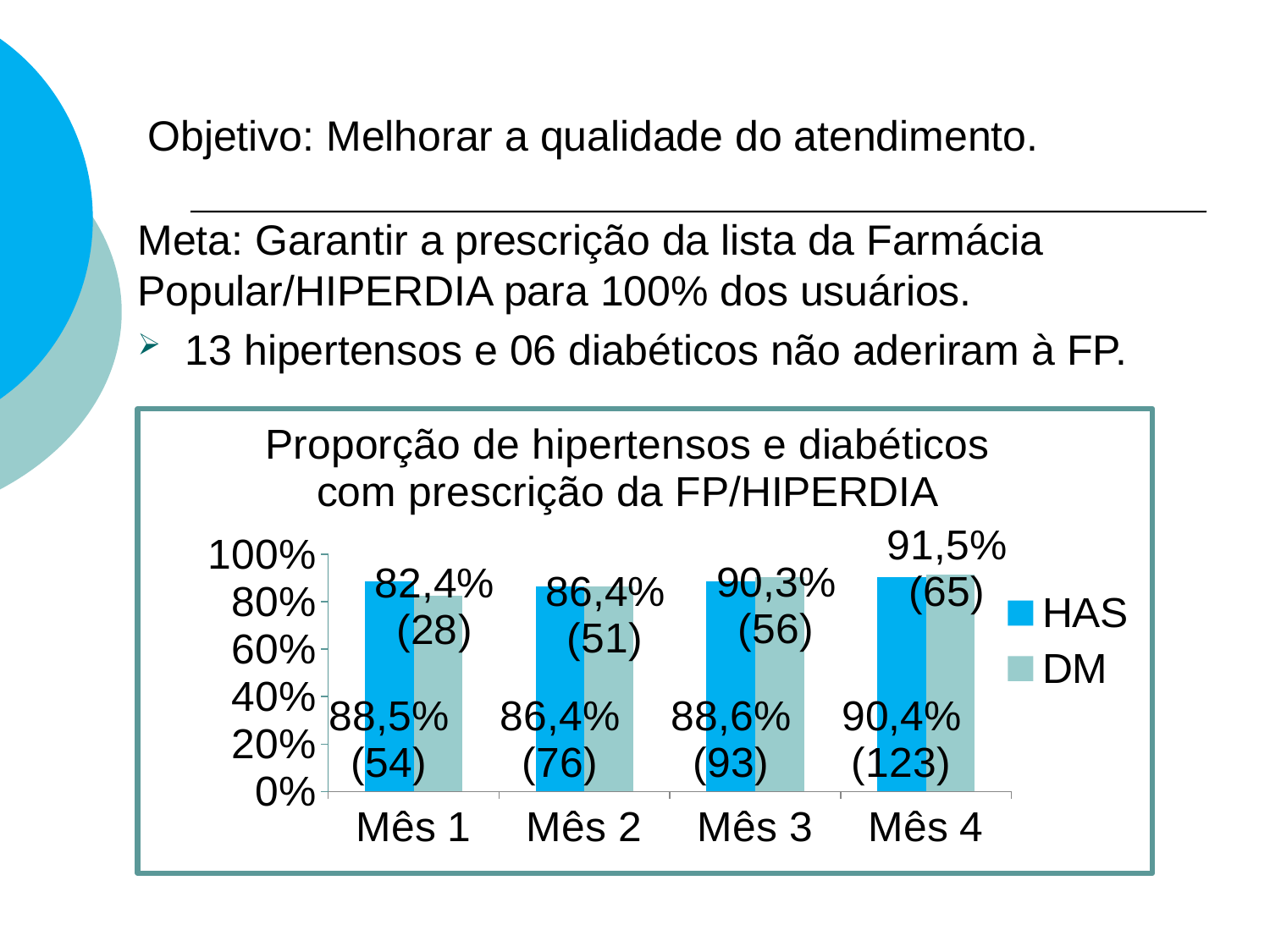
Which is larger in Mês 1, the HAS value or the DM value? HAS How many series does the legend list? 2 In which month is the DM value lowest? Mês 1 What is the HAS value for Mês 4? 90,4% What is the difference between the DM value in Mês 4 and the DM value in Mês 1? 9,1 percentage points What type of chart is shown on the slide? Bar chart In which month is the HAS value lowest? Mês 2 What is the HAS value for Mês 1? 88,5% How many months (categories) are shown on the x axis? 4 What is the DM value for Mês 3? 90,3% Do the DM values rise or fall from Mês 1 to Mês 4? Rise In which month is the DM value highest? Mês 4